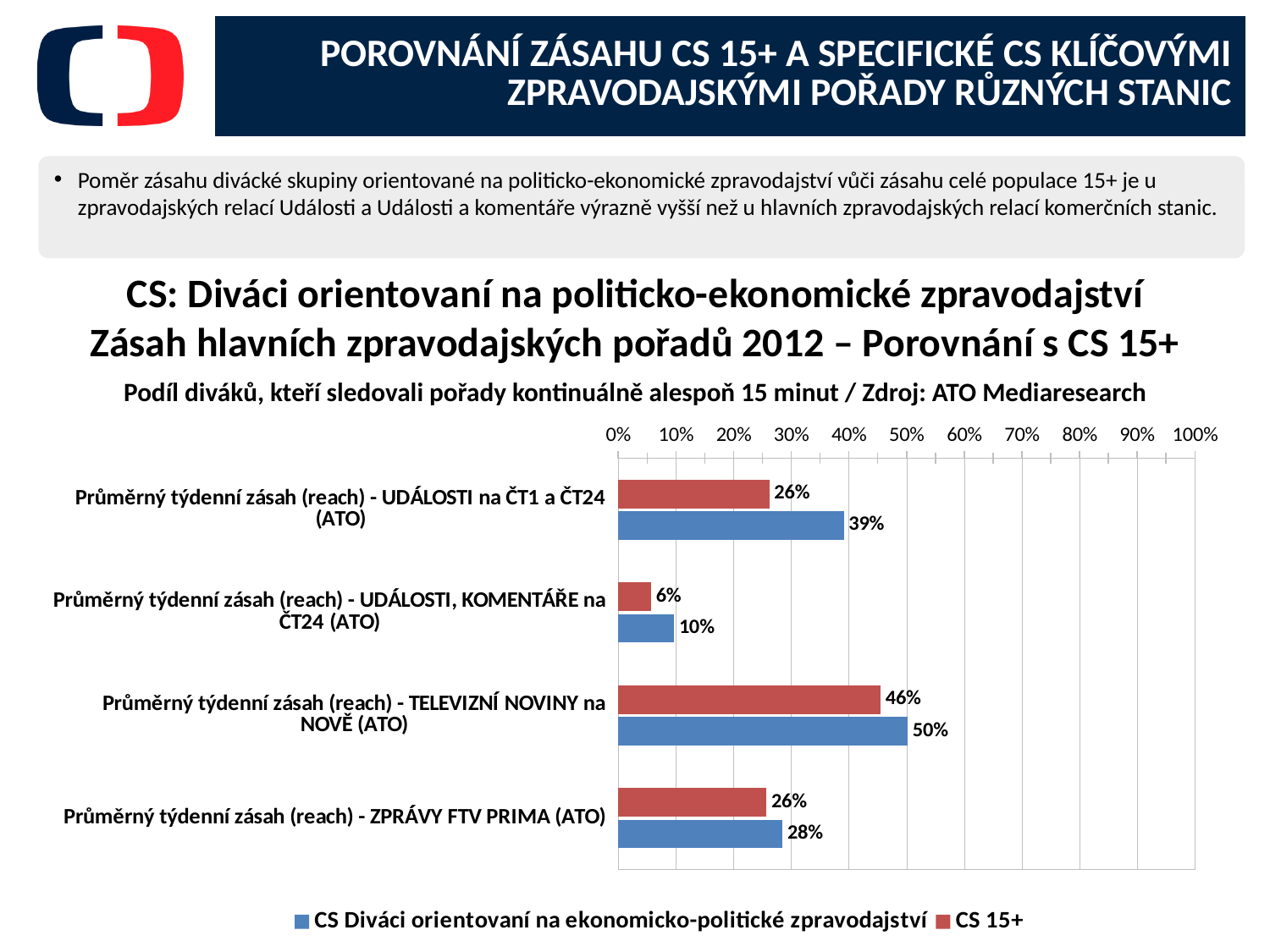
What is the difference between the two series for 'Průměrný týdenní zásah (reach) - UDÁLOSTI na ČT1 a ČT24 (ATO)'? 13% Which category has the highest value for 'CS Diváci orientovaní na ekonomicko-politické zpravodajství'? Průměrný týdenní zásah (reach) - TELEVIZNÍ NOVINY na NOVĚ (ATO) Which category has the lowest value for CS 15+? Průměrný týdenní zásah (reach) - UDÁLOSTI, KOMENTÁŘE na ČT24 (ATO) Which colour represents the CS 15+ series in the chart? red How many categories are plotted on the chart? 4 How many series does the legend list? 2 What source is cited in the chart subtitle? ATO Mediaresearch What type of chart is shown on the slide? bar chart What is the value for CS 15+ for 'Průměrný týdenní zásah (reach) - UDÁLOSTI na ČT1 a ČT24 (ATO)'? 26% What is the value for CS 15+ for 'Průměrný týdenní zásah (reach) - TELEVIZNÍ NOVINY na NOVĚ (ATO)'? 46% What is the value for 'CS Diváci orientovaní na ekonomicko-politické zpravodajství' for 'Průměrný týdenní zásah (reach) - UDÁLOSTI, KOMENTÁŘE na ČT24 (ATO)'? 10% For 'Průměrný týdenní zásah (reach) - ZPRÁVY FTV PRIMA (ATO)', which series has the larger value? CS Diváci orientovaní na ekonomicko-politické zpravodajství